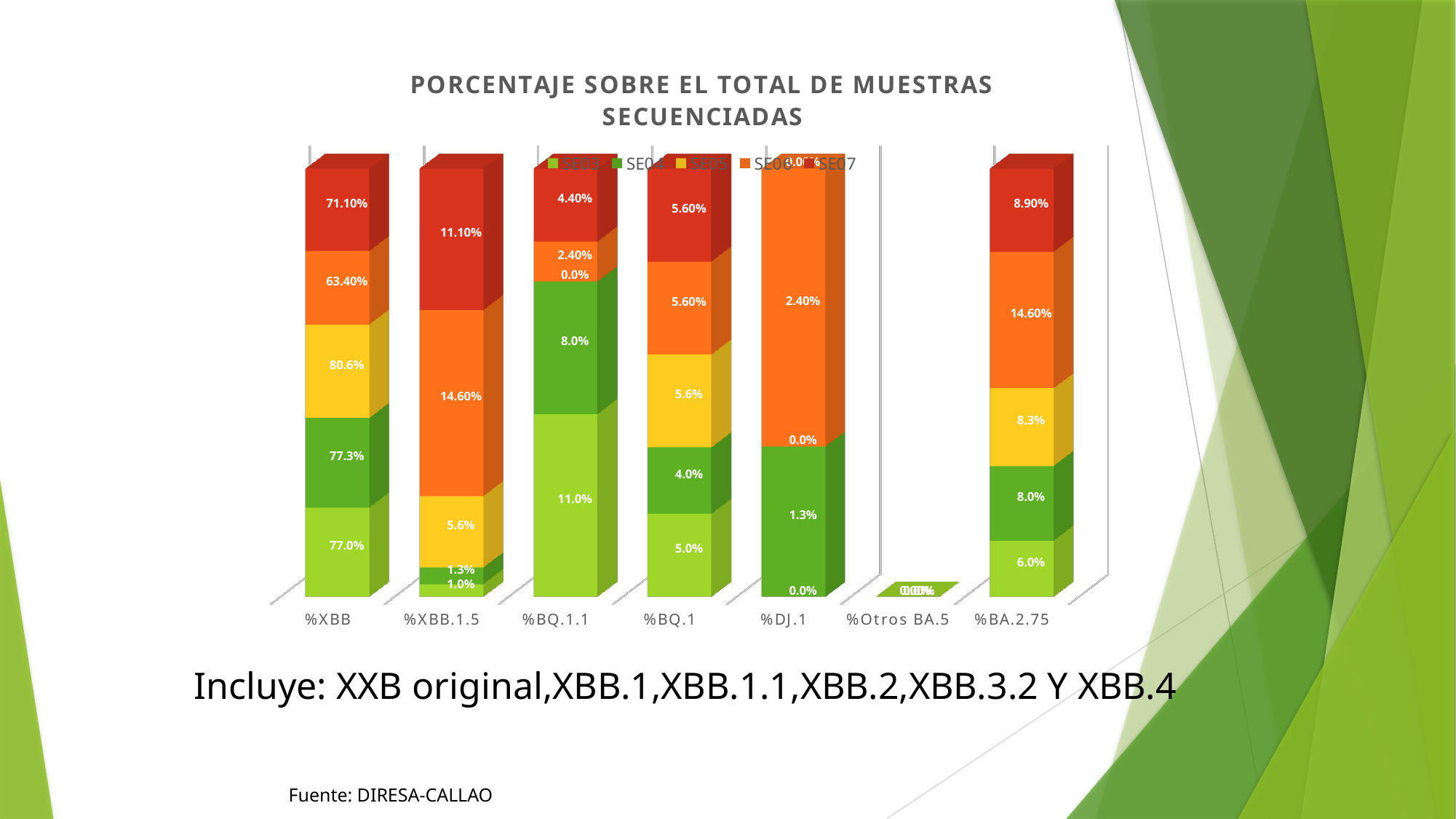
Which series has the lowest value for %XBB.1.5? SE03 How many categories are shown on the x axis? 7 What is the SE03 value for %XBB? 77.0% Which is larger for %BA.2.75: the SE06 value or the SE05 value? SE06 Which series has the highest value for %XBB? SE05 What is the SE05 value for %BQ.1? 5.6% What is the SE06 value for %XBB.1.5? 14.60% What kind of chart is shown on the slide? Stacked bar chart What is the SE04 value for %BQ.1.1? 8.0% What is the SE07 value for %BA.2.75? 8.90% What is the difference between the SE03 and SE04 values for %BQ.1.1? 3.0% How many series does the legend list? 5